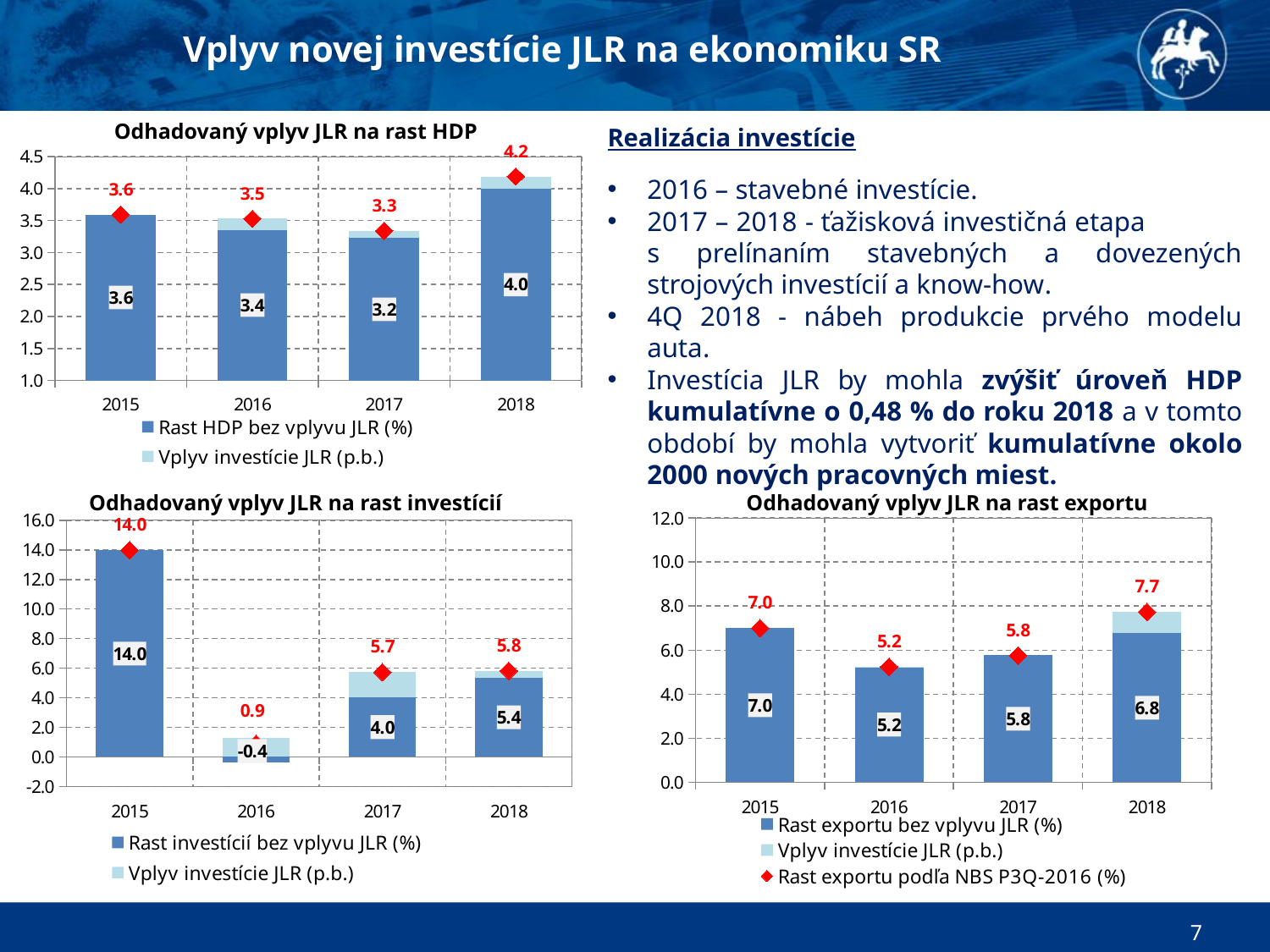
In the chart 'Odhadovaný vplyv JLR na rast exportu', how many series does the legend list? 3 In the chart 'Odhadovaný vplyv JLR na rast exportu', is the value of 'Rast exportu bez vplyvu JLR (%)' for 2016 larger or smaller than for 2017? smaller In the chart 'Odhadovaný vplyv JLR na rast investícií', how many years are shown on the x axis? 4 In the chart 'Odhadovaný vplyv JLR na rast investícií', what is the difference between the red diamond value and the dark blue bar value for 2017? 1.7 In the chart 'Odhadovaný vplyv JLR na rast investícií', what is the value of 'Rast investícií bez vplyvu JLR (%)' for 2016? -0.4 What kind of chart is 'Odhadovaný vplyv JLR na rast exportu'? bar chart In the chart 'Odhadovaný vplyv JLR na rast investícií', which year has the highest red diamond value? 2015 In the chart 'Odhadovaný vplyv JLR na rast HDP', what is the value of 'Rast HDP bez vplyvu JLR (%)' for 2018? 4.0 In the chart 'Odhadovaný vplyv JLR na rast exportu', what is the value of 'Rast exportu podľa NBS P3Q-2016 (%)' for 2018? 7.7 In the chart 'Odhadovaný vplyv JLR na rast HDP', which year has the lowest value of 'Rast HDP bez vplyvu JLR (%)'? 2017 In the chart 'Odhadovaný vplyv JLR na rast HDP', what is the difference between the red diamond value and the dark blue bar value for 2018? 0.2 In the chart 'Odhadovaný vplyv JLR na rast HDP', what is the red diamond value shown for 2016? 3.5